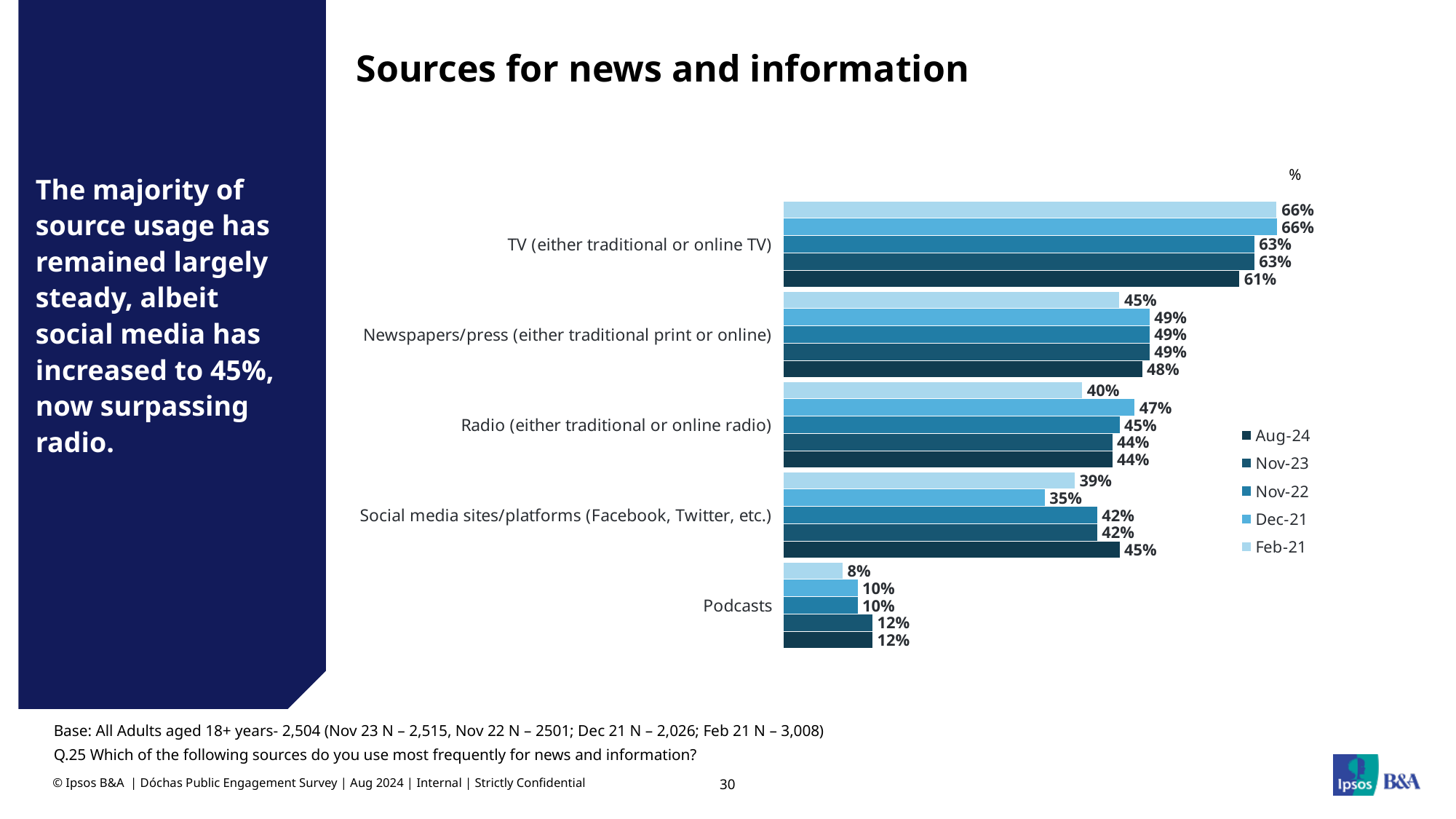
In Aug-24, which is larger: the value for Radio (either traditional or online radio) or for Social media sites/platforms (Facebook, Twitter, etc.)? Social media sites/platforms (Facebook, Twitter, etc.) Which source has the highest Feb-21 value? TV (either traditional or online TV) How many source categories are shown on the chart? 5 What is the Aug-24 value for Social media sites/platforms (Facebook, Twitter, etc.)? 45% What is the title of the chart? Sources for news and information What kind of chart is shown on the slide? Bar chart How many series does the legend list? 5 Did the value for Podcasts rise or fall from Feb-21 to Aug-24? Rise What is the difference between the Feb-21 and Aug-24 values for TV (either traditional or online TV)? 5% What is the Aug-24 value for TV (either traditional or online TV)? 61% What is the Feb-21 value for Podcasts? 8% Which source has the lowest Aug-24 value? Podcasts